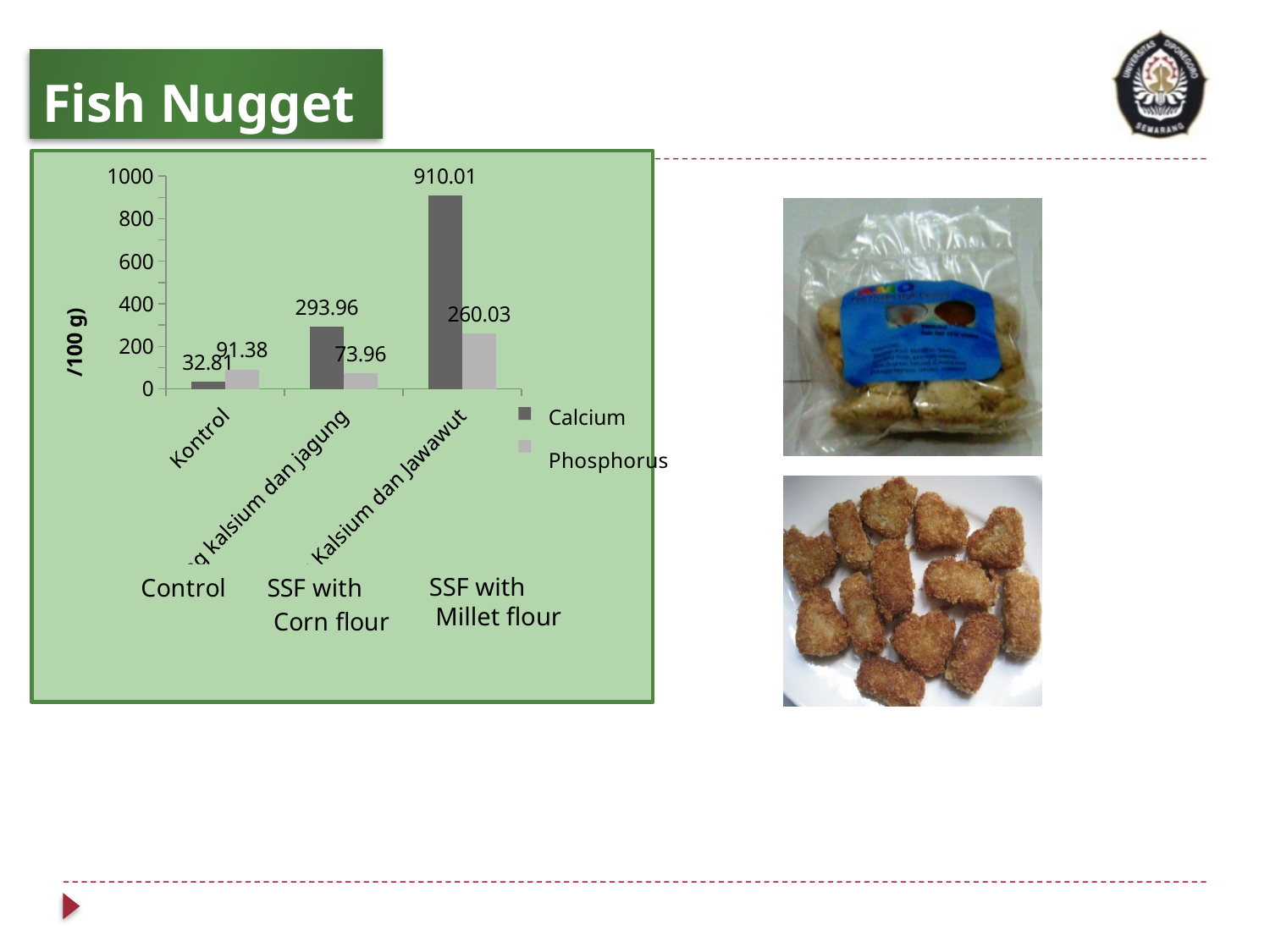
For the Control category, which is larger, Calcium or Phosphorus? Phosphorus What is the difference between the Calcium values for SSF with Millet flour and SSF with Corn flour? 616.05 How many categories are shown on the x axis of the chart? 3 What is the Calcium value for the SSF with Corn flour fish nugget? 293.96 What is the Phosphorus value for the SSF with Corn flour fish nugget? 73.96 What kind of chart is shown on the slide? bar chart How many series does the chart legend list? 2 What is the Phosphorus value for the Control fish nugget? 91.38 Is the Calcium value for SSF with Millet flour greater or less than 800? greater What is the Calcium value for the SSF with Millet flour fish nugget? 910.01 Which category has the highest Calcium value? SSF with Millet flour Which category has the lowest Phosphorus value? SSF with Corn flour